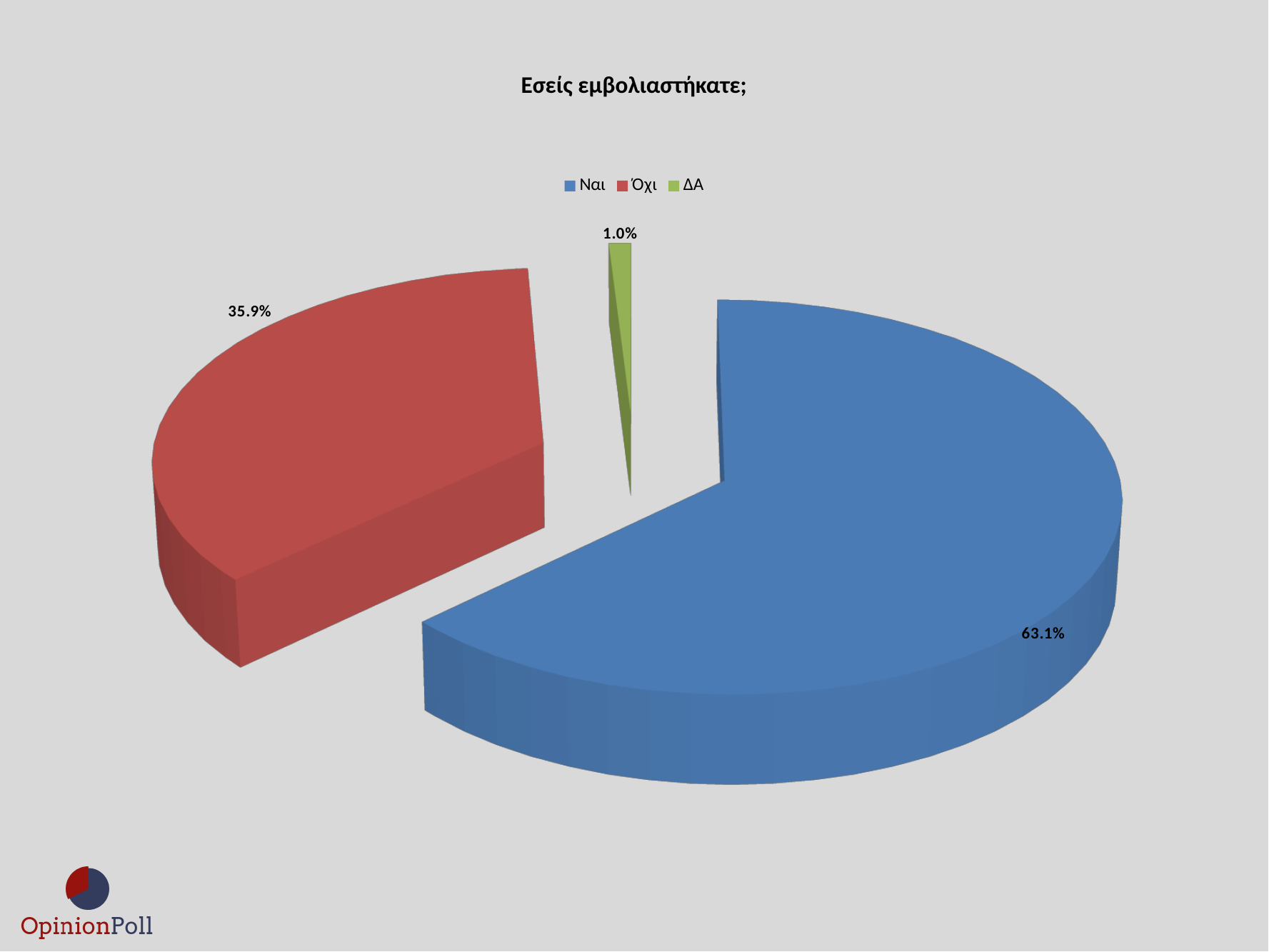
What percentage of the pie is the ΔΑ slice? 1.0% What kind of chart is shown on the slide? pie chart How many categories does the legend list? 3 Which category has the largest slice of the pie? Ναι Is the value for Ναι greater or less than 50%? greater What is the difference in percentage points between the Ναι and Όχι slices? 27.2 What colour is the Όχι slice? red What percentage of the pie is the Ναι slice? 63.1% What percentage of the pie is the Όχι slice? 35.9% Which category has the smallest slice of the pie? ΔΑ What is the title of the chart? Εσείς εμβολιαστήκατε; Which is larger, the Όχι slice or the ΔΑ slice? Όχι